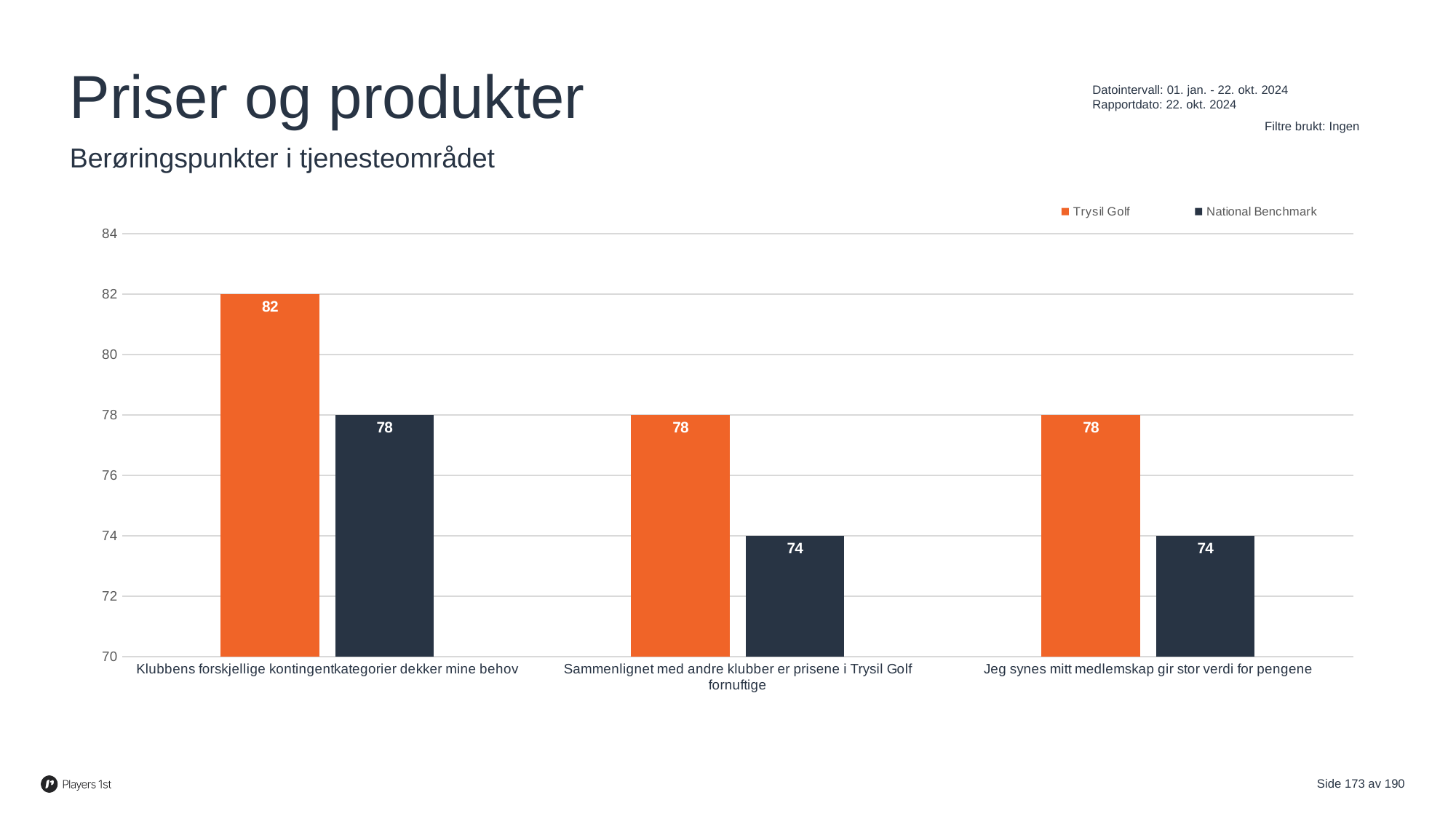
How many categories are shown on the x axis? 3 Which colour represents the National Benchmark series? Dark navy What is the National Benchmark value for "Klubbens forskjellige kontingentkategorier dekker mine behov"? 78 What kind of chart is shown on the slide? Bar chart Which category has the highest Trysil Golf value? Klubbens forskjellige kontingentkategorier dekker mine behov What is the Trysil Golf value for "Klubbens forskjellige kontingentkategorier dekker mine behov"? 82 What is the difference between the Trysil Golf and National Benchmark values for "Klubbens forskjellige kontingentkategorier dekker mine behov"? 4 What is the difference between the Trysil Golf and National Benchmark values for "Jeg synes mitt medlemskap gir stor verdi for pengene"? 4 For "Sammenlignet med andre klubber er prisene i Trysil Golf fornuftige", which is larger: Trysil Golf or National Benchmark? Trysil Golf What is the Trysil Golf value for "Jeg synes mitt medlemskap gir stor verdi for pengene"? 78 What is the National Benchmark value for "Sammenlignet med andre klubber er prisene i Trysil Golf fornuftige"? 74 How many series does the legend list? 2